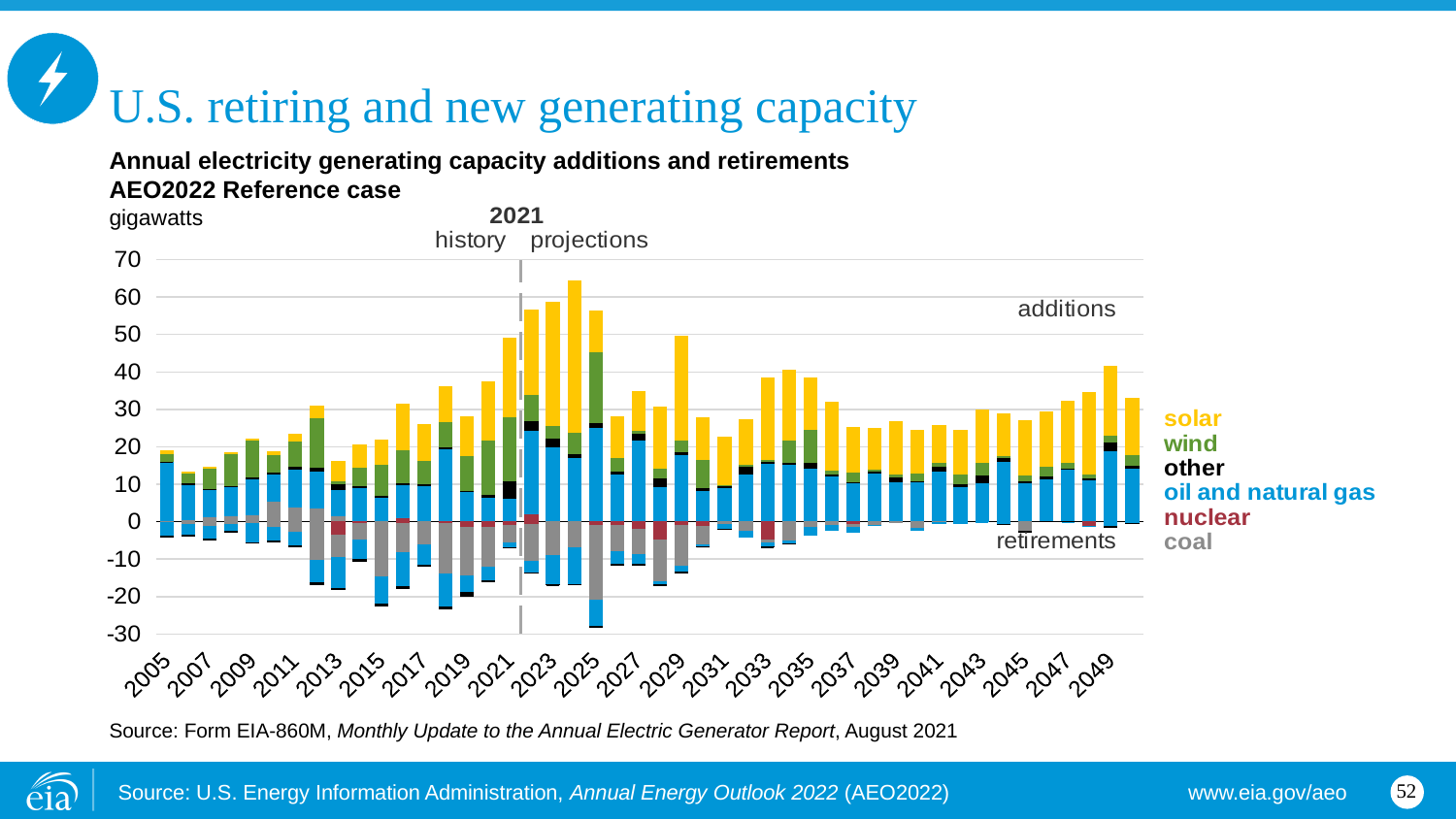
What unit is the y axis measured in? gigawatts Is the total additions value for 2024 greater or less than 60 gigawatts? greater Do total additions rise or fall from 2021 to 2024? rise Is the total retirements value for 2025 greater or less than -20 gigawatts? less Which year does the dashed line separating history from projections mark? 2021 Which year has larger total additions, 2024 or 2013? 2024 Is the total additions value for 2031 greater or less than 30 gigawatts? less Which year has the highest total capacity additions? 2024 Do total additions rise or fall from 2024 to 2026? fall How many series does the legend list? 6 What kind of chart is shown on the slide? stacked bar chart